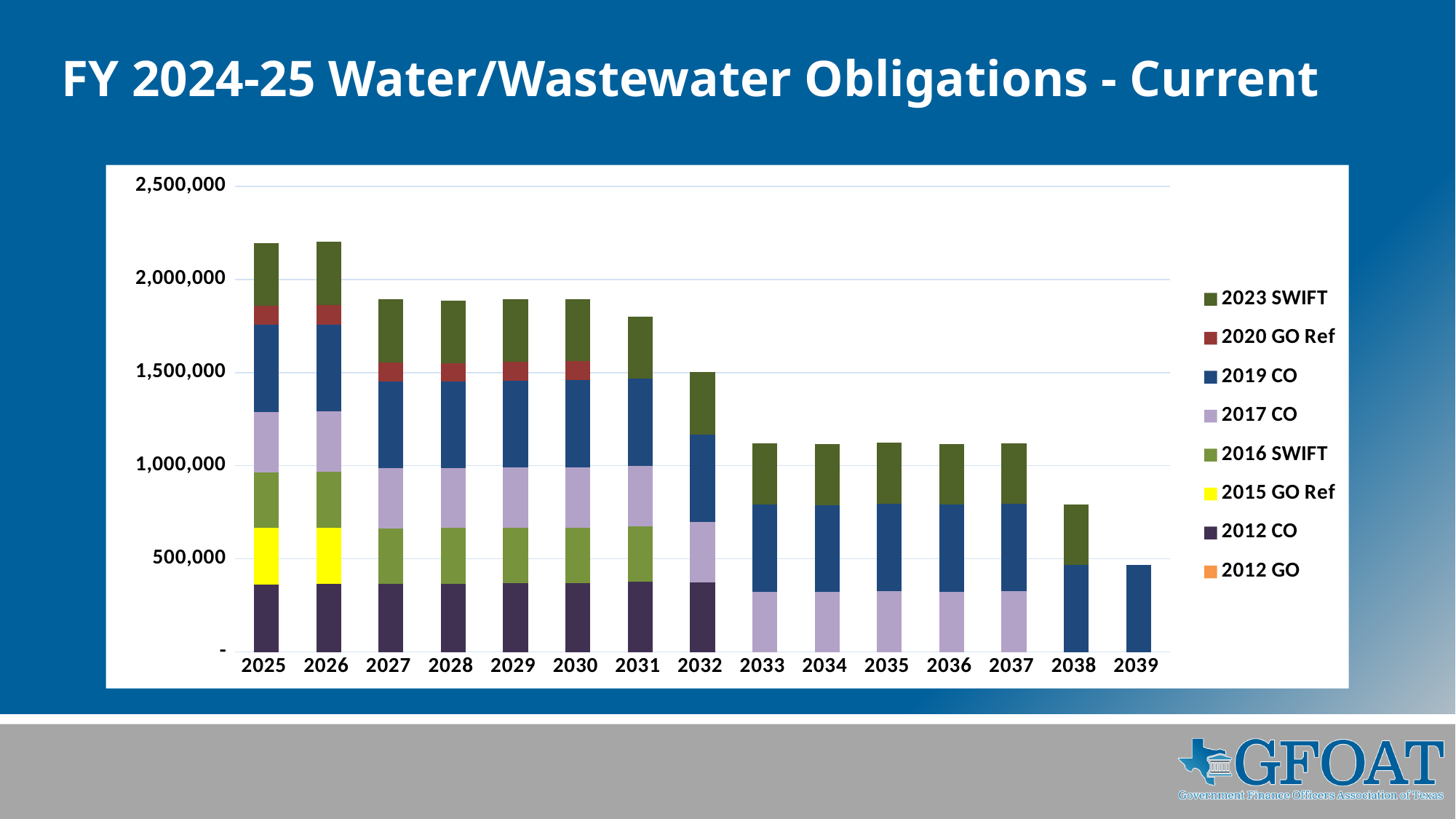
Is the total value for 2039 greater or less than 500,000? less Which year has the larger total obligation, 2038 or 2039? 2038 How many series does the chart's legend list? 8 Is the total value for 2038 greater or less than 500,000? greater What kind of chart is shown on the slide? stacked bar chart How many years are shown along the x axis of the chart? 15 Which year has the larger total obligation, 2031 or 2032? 2031 Is the total value for 2025 greater or less than 2,000,000? greater Do the total obligations generally rise or fall from 2025 to 2039? fall Which legend entry is shown in yellow? 2015 GO Ref Which year has the lowest total obligation in the chart? 2039